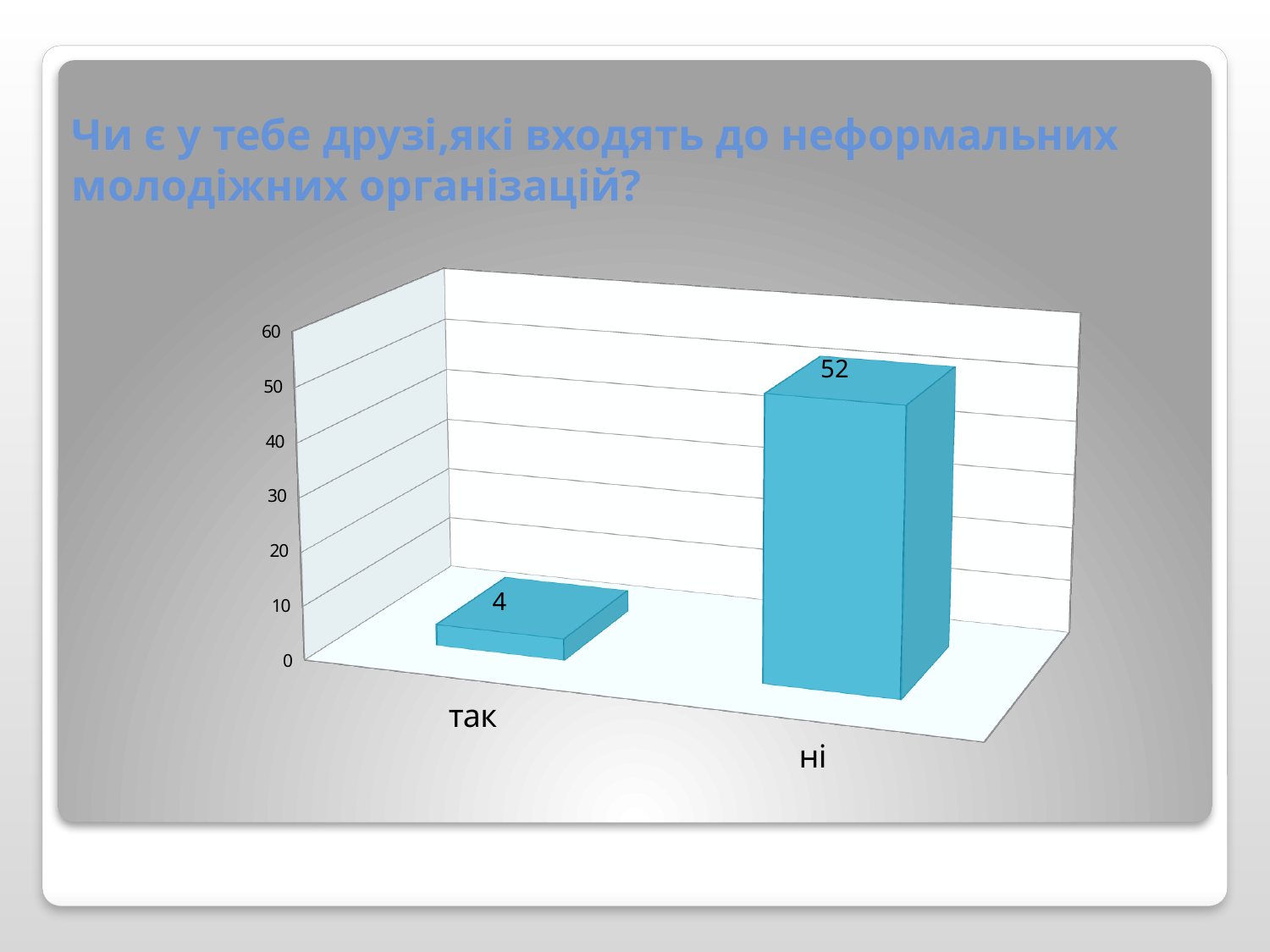
Which is larger, the value for "так" or the value for "ні"? ні How many categories are shown on the chart? 2 Is the value for "ні" greater or less than 50? greater What is the value for "так"? 4 Is the value for "так" greater or less than 10? less What is the total of the two values shown on the chart? 56 What is the highest value shown on the vertical axis? 60 What kind of chart is shown on the slide? bar chart Which category has the lowest value? так What is the difference between the values for "ні" and "так"? 48 What is the value for "ні"? 52 Which category has the highest value? ні